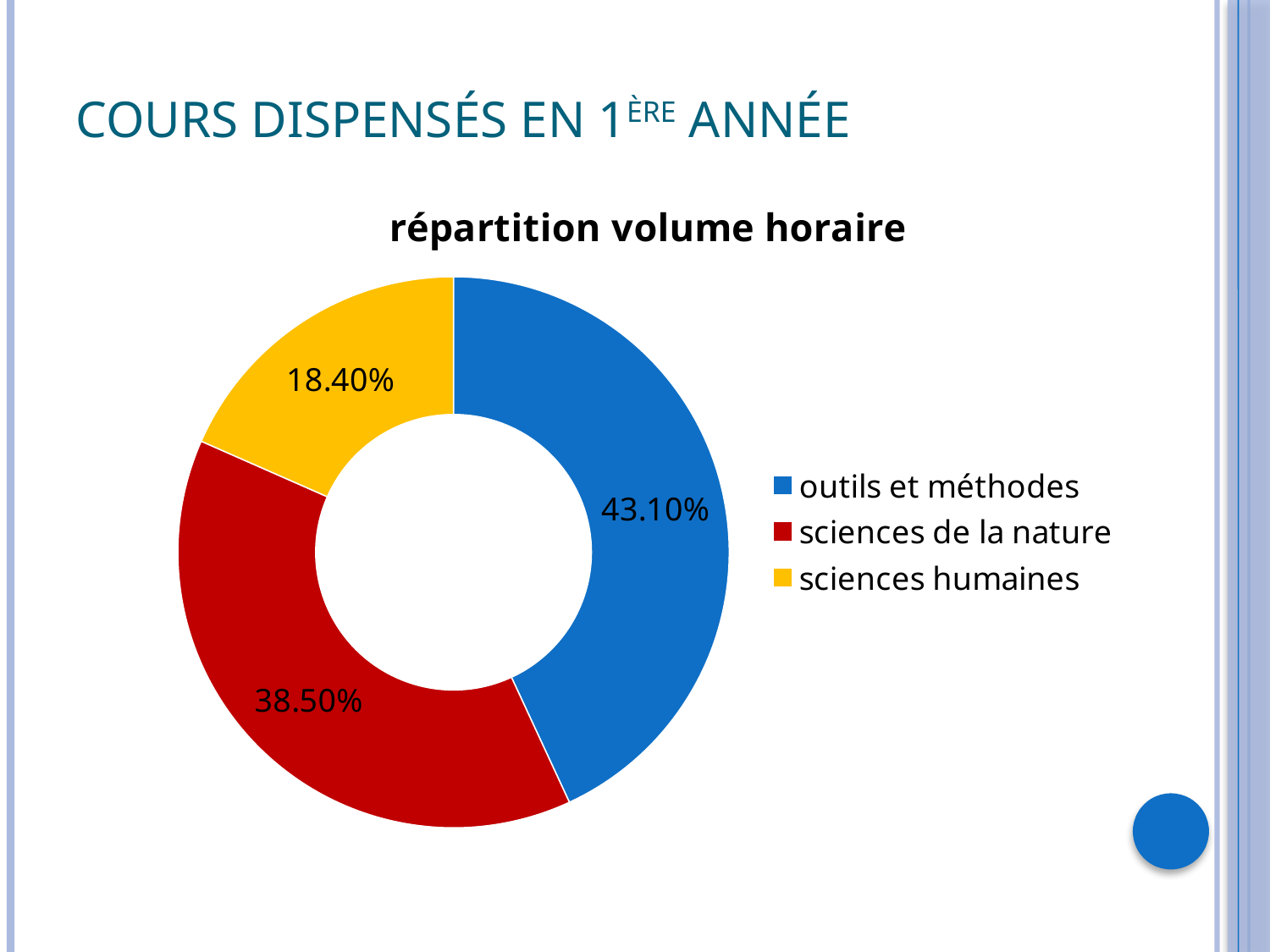
What share of the chart does 'sciences de la nature' represent? 38.50% Which is larger: the share for 'sciences de la nature' or the share for 'sciences humaines'? sciences de la nature What is the title of the chart? répartition volume horaire Which category has the smallest share of the chart? sciences humaines What kind of chart is shown on the slide? doughnut chart What is the difference in percentage points between 'outils et méthodes' and 'sciences de la nature'? 4.60 What colour represents 'sciences humaines' in the chart? yellow What share of the chart does 'sciences humaines' represent? 18.40% What is the difference in percentage points between 'sciences de la nature' and 'sciences humaines'? 20.10 What share of the chart does 'outils et méthodes' represent? 43.10% How many categories are shown in the chart? 3 Which category has the largest share of the chart? outils et méthodes